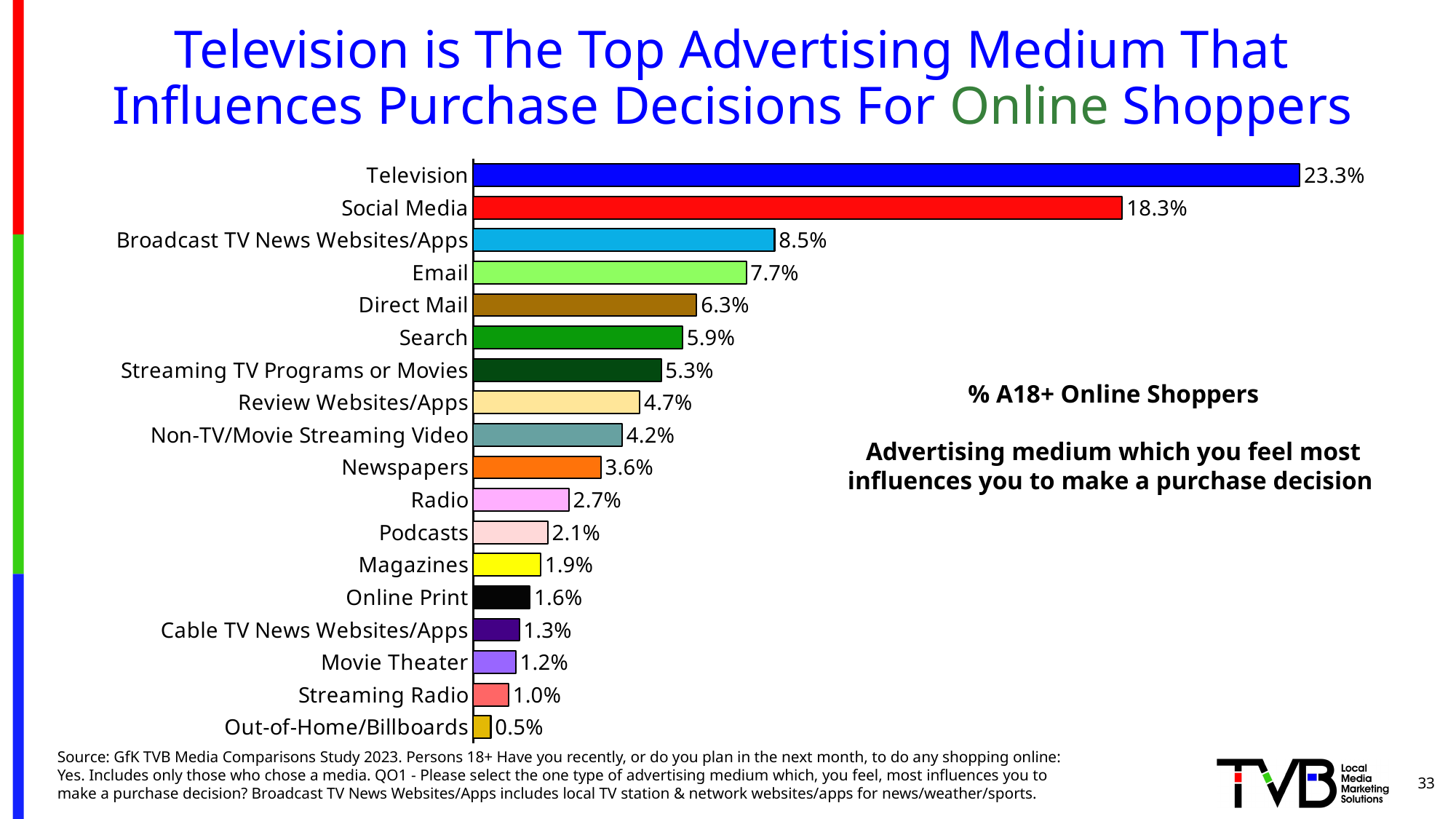
What colour is the bar for Magazines? Yellow Which advertising medium has the lowest value on the chart? Out-of-Home/Billboards What is the value shown for Podcasts? 2.1% Which advertising medium has the highest value on the chart? Television What is the difference between the values for Television and Social Media? 5.0% What percentage of A18+ online shoppers chose Television as the advertising medium that most influences their purchase decision? 23.3% What is the value shown for Social Media? 18.3% What type of chart is shown on the slide? Bar chart Which has a larger value, Newspapers or Radio? Newspapers What is the value shown for Direct Mail? 6.3% How many advertising media are listed on the chart? 18 What is the difference between the values for Email and Search? 1.8%